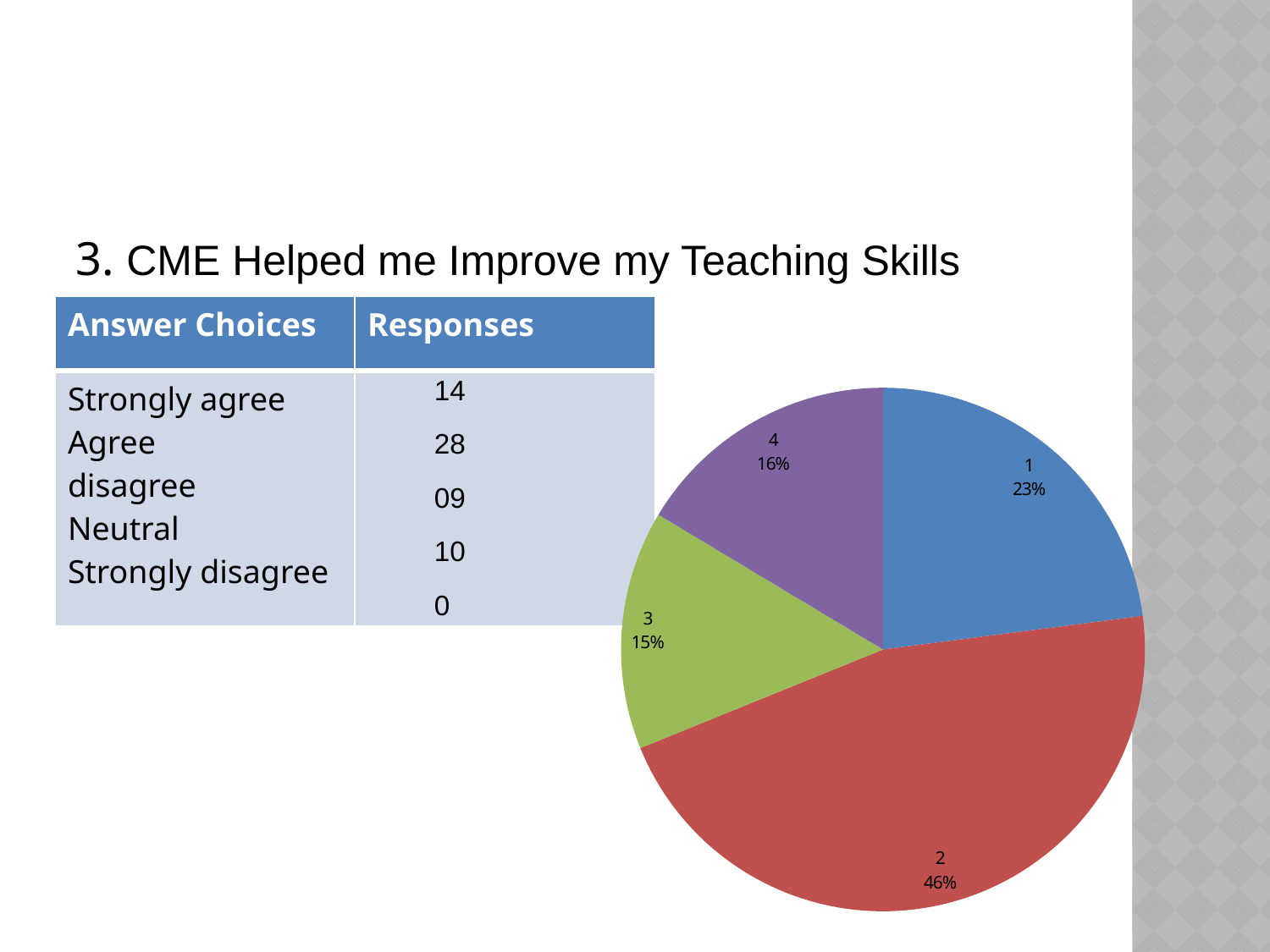
How many slices does the pie chart have? 4 What percentage is shown for slice 2 of the pie chart? 46% What colour is the largest slice of the pie chart? red Which is larger in the pie chart, slice 1 or slice 4? 1 What kind of chart is shown on the slide? pie chart What is the combined share of slices 3 and 4 in the pie chart? 31% What percentage is shown for slice 1 of the pie chart? 23% What is the difference in percentage points between slice 2 and slice 1 of the pie chart? 23 What percentage is shown for slice 3 of the pie chart? 15% What percentage is shown for slice 4 of the pie chart? 16% Which slice of the pie chart is the largest? 2 Which slice of the pie chart is the smallest? 3